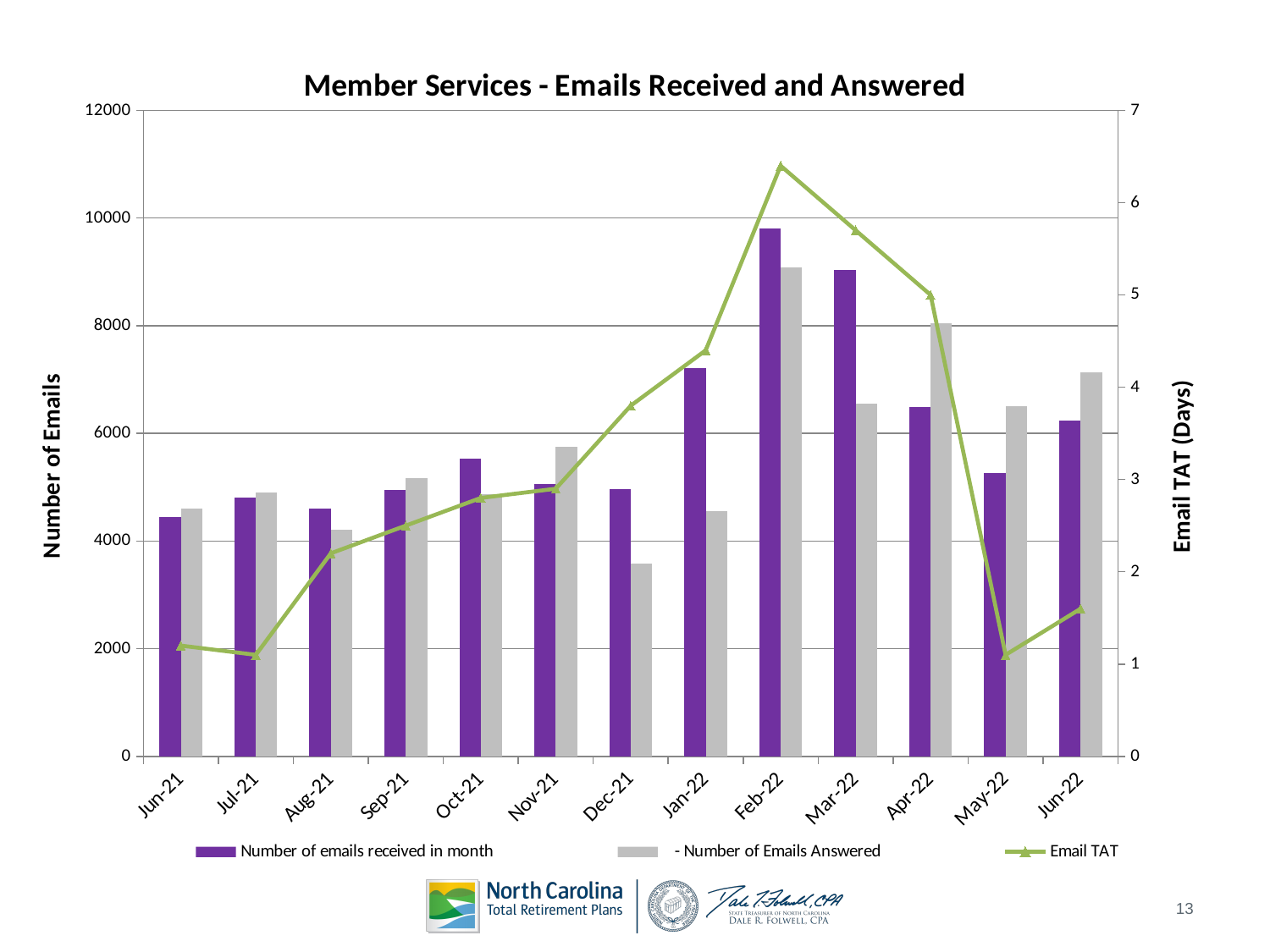
Is the number of emails received in Feb-22 greater or less than 8000? greater In which month was the number of emails received in month highest? Feb-22 Does the Email TAT rise or fall from Feb-22 to May-22? Fall In Apr-22, which is larger: the number of emails received in month or the number of emails answered? Number of Emails Answered How many months are shown on the x axis? 13 What is the title of the right-hand vertical axis? Email TAT (Days) How many series does the legend list? 3 What kind of chart is shown on the slide? A combined bar and line chart In Jan-22, which is larger: the number of emails received in month or the number of emails answered? Number of emails received in month Is the number of emails answered in Dec-21 greater or less than 4000? less In which month was the Email TAT highest? Feb-22 In which month was the number of emails answered lowest? Dec-21